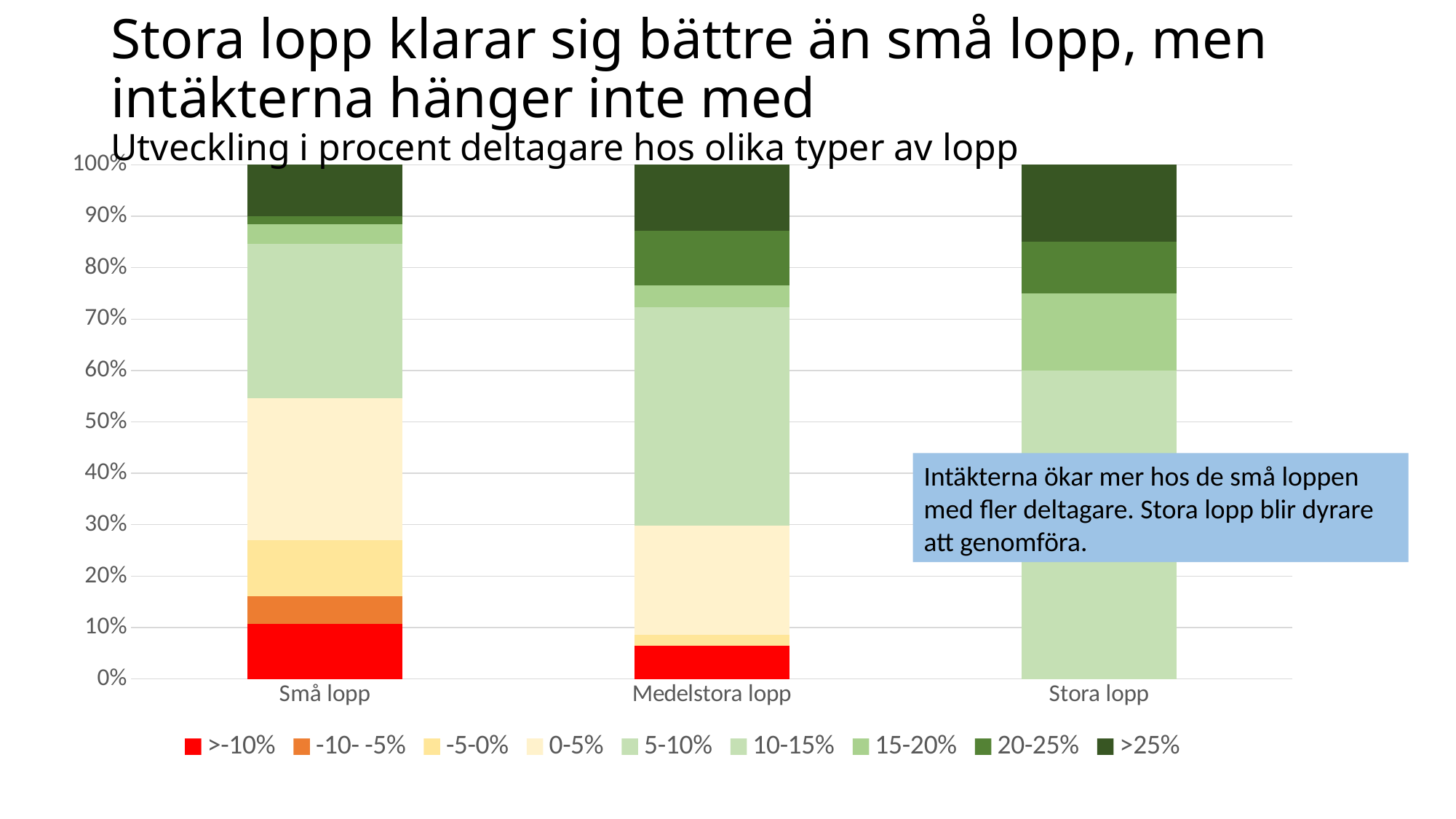
What is the title of the chart? Utveckling i procent deltagare hos olika typer av lopp How many series does the chart's legend list? 9 Which category has the largest share of the 0-5% series? Små lopp Is the 10-15% share larger for Stora lopp or for Små lopp? Stora lopp Which legend entry is shown in red? >-10% Is the share of the 0-5% series for Små lopp greater or less than 20%? greater Is the share of the >-10% series for Medelstora lopp greater or less than 10%? less How many categories are shown on the x axis of the chart? 3 Which category has the largest share of the >-10% series? Små lopp What kind of chart is shown on the slide? Stacked bar chart